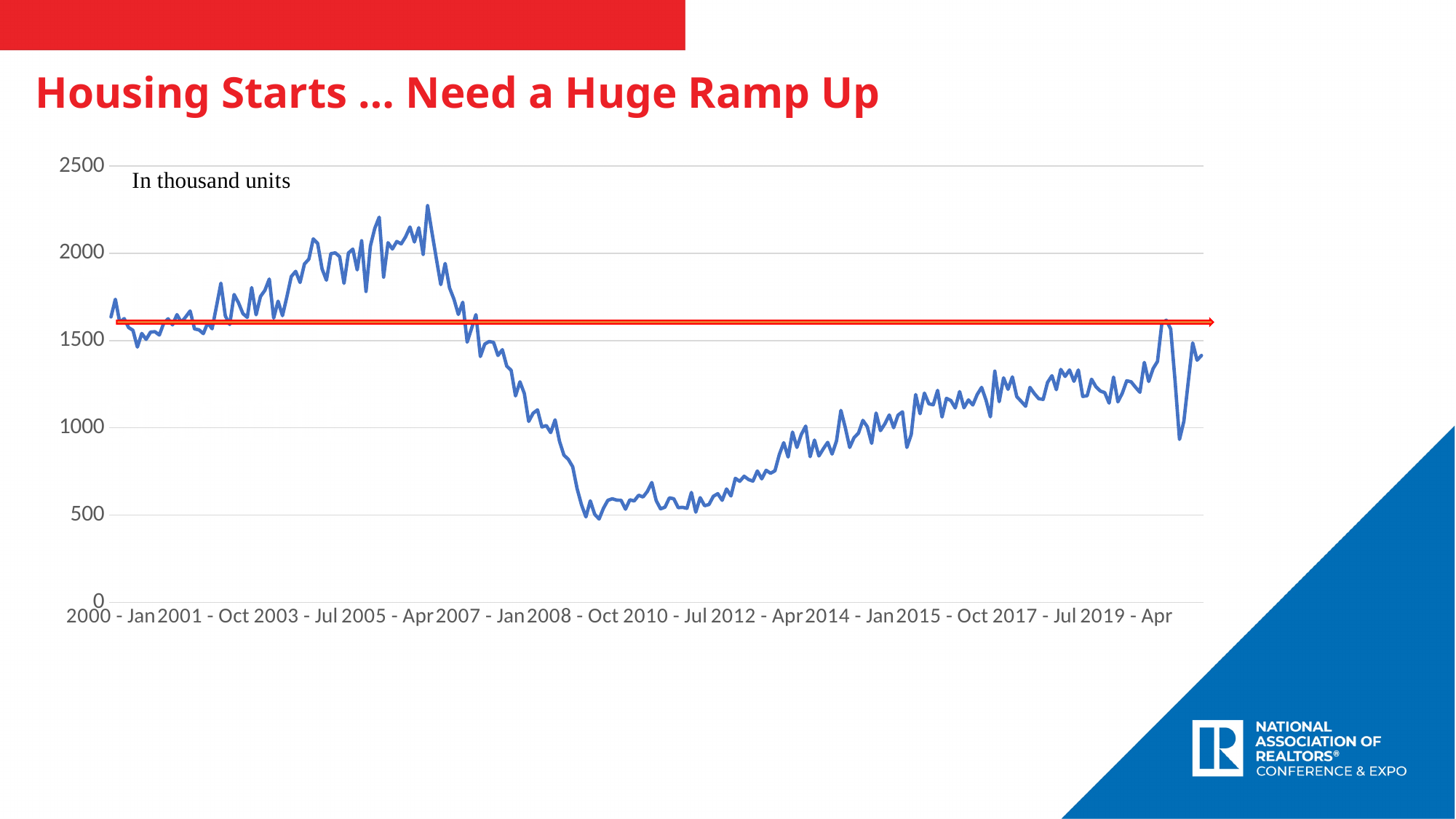
Is the value for 2000 - Jan greater or less than 1500? greater What is the title of the chart on the slide? Housing Starts … Need a Huge Ramp Up In what units are the values on the chart expressed? In thousand units Does the line rise or fall between 2007 - Jan and 2008 - Oct? fall What kind of chart is shown on the slide? line chart Is the value for 2003 - Jul greater or less than 1500? greater Is the value for 2019 - Apr greater or less than 1500? less How many date labels are shown on the x axis? 12 Does the line generally rise or fall between 2010 - Jul and 2019 - Apr? rise